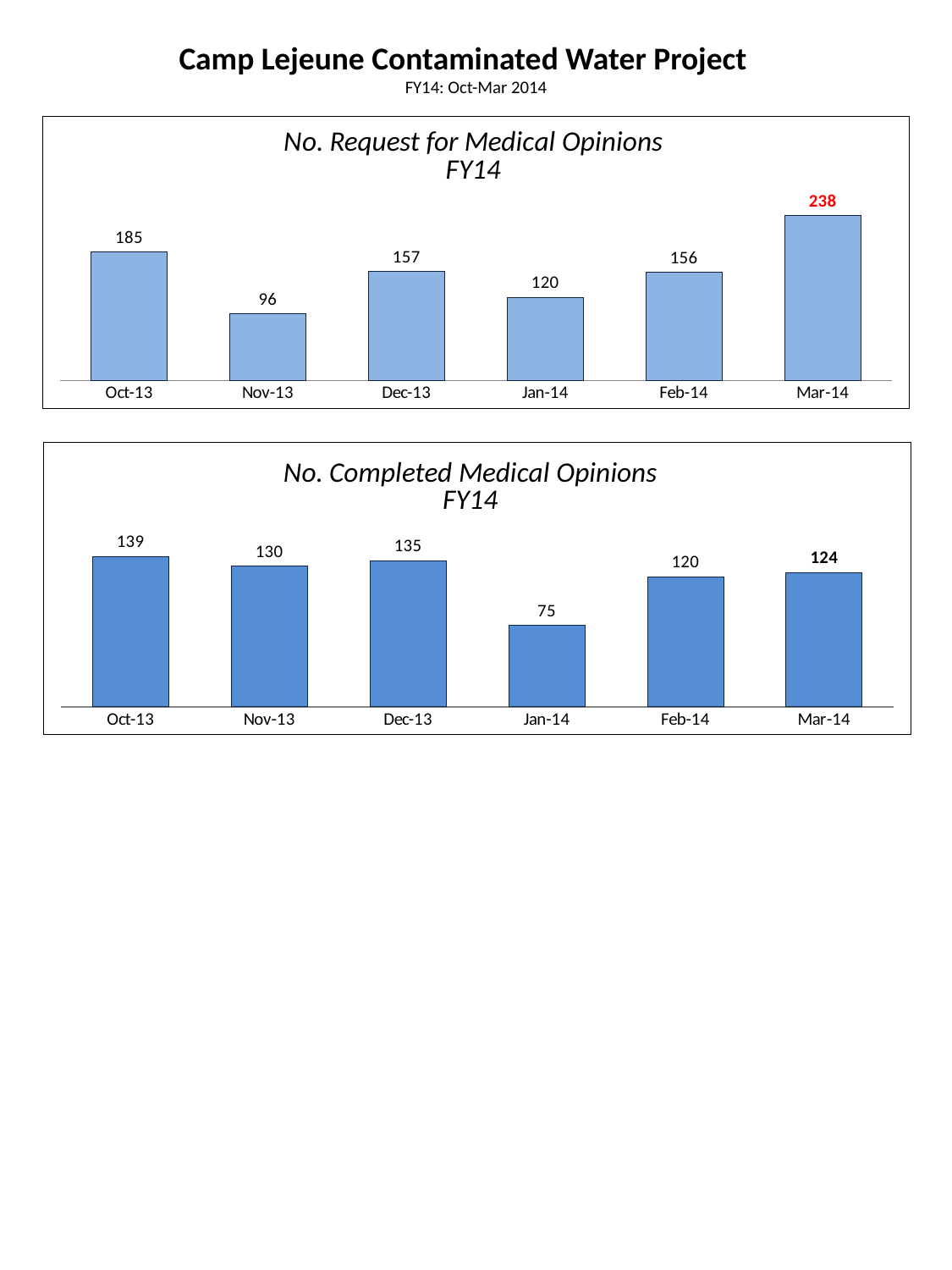
In the 'No. Request for Medical Opinions FY14' chart, what is the value for Mar-14? 238 How many months are shown in the 'No. Request for Medical Opinions FY14' chart? 6 In the 'No. Completed Medical Opinions FY14' chart, what is the value for Jan-14? 75 In the 'No. Request for Medical Opinions FY14' chart, what is the difference between the Mar-14 and Oct-13 values? 53 In the 'No. Completed Medical Opinions FY14' chart, which month has the highest value? Oct-13 In the 'No. Request for Medical Opinions FY14' chart, which month has the lowest value? Nov-13 What kind of chart is the 'No. Completed Medical Opinions FY14' chart? Bar chart In the 'No. Request for Medical Opinions FY14' chart, which is larger, the value for Dec-13 or the value for Jan-14? Dec-13 In the 'No. Request for Medical Opinions FY14' chart, does the value rise or fall from Feb-14 to Mar-14? Rise In the 'No. Completed Medical Opinions FY14' chart, which is larger, the value for Nov-13 or the value for Feb-14? Nov-13 In the 'No. Request for Medical Opinions FY14' chart, which data label is shown in red? 238 (Mar-14) In the 'No. Completed Medical Opinions FY14' chart, what is the difference between the Oct-13 and Jan-14 values? 64